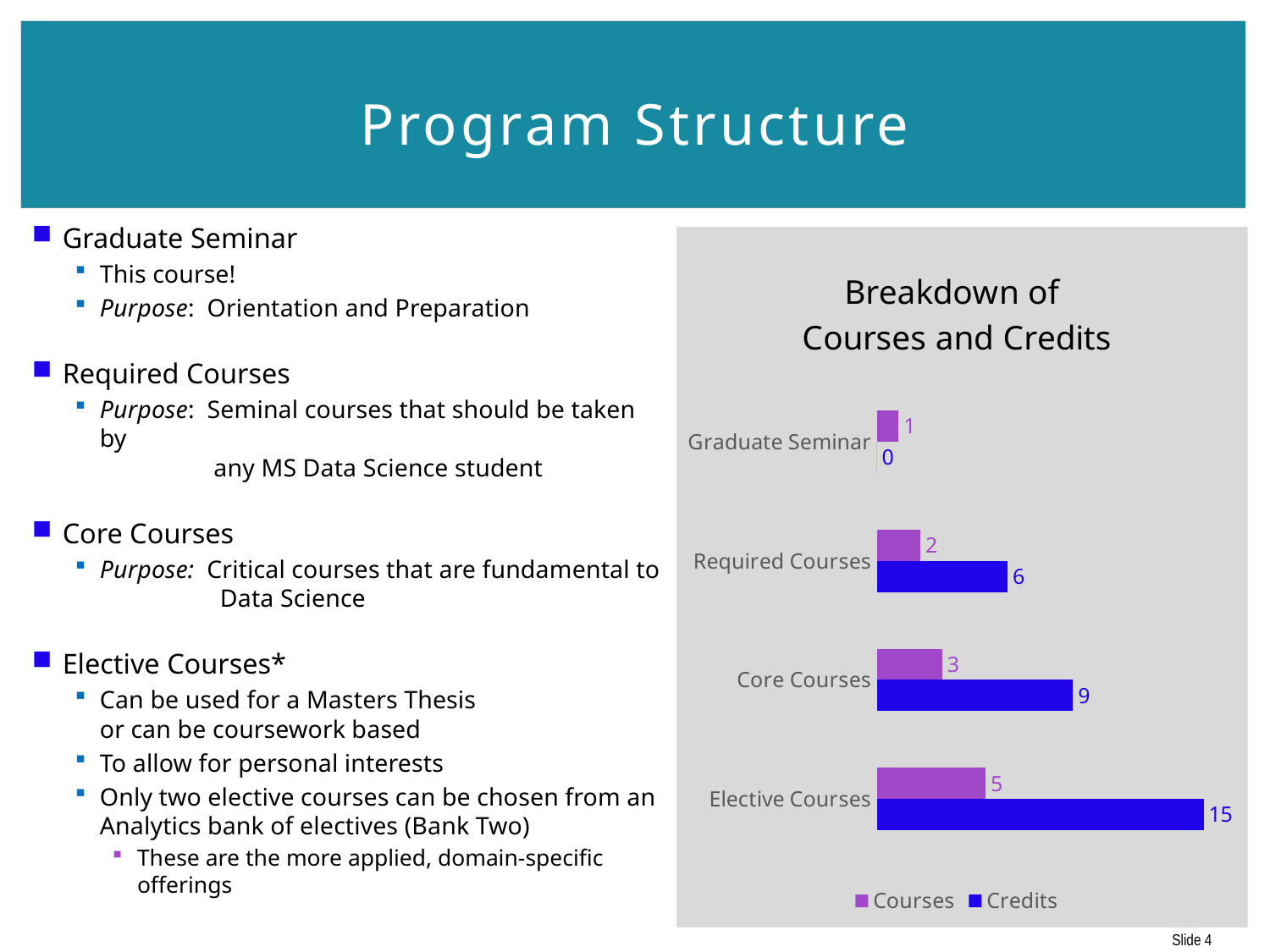
Which category has the lowest Courses value? Graduate Seminar How many series does the chart legend list? 2 What type of chart is shown on the slide? Bar chart Which is larger, the Credits value for Required Courses or the Credits value for Core Courses? Core Courses What is the total of Courses and Credits for Required Courses? 8 What is the Courses value for Core Courses? 3 What is the Credits value for Elective Courses? 15 What is the difference between the Credits values for Elective Courses and Core Courses? 6 What is the title of the chart? Breakdown of Courses and Credits What is the Credits value for Graduate Seminar? 0 How many categories are shown in the chart? 4 Which category has the highest Credits value? Elective Courses